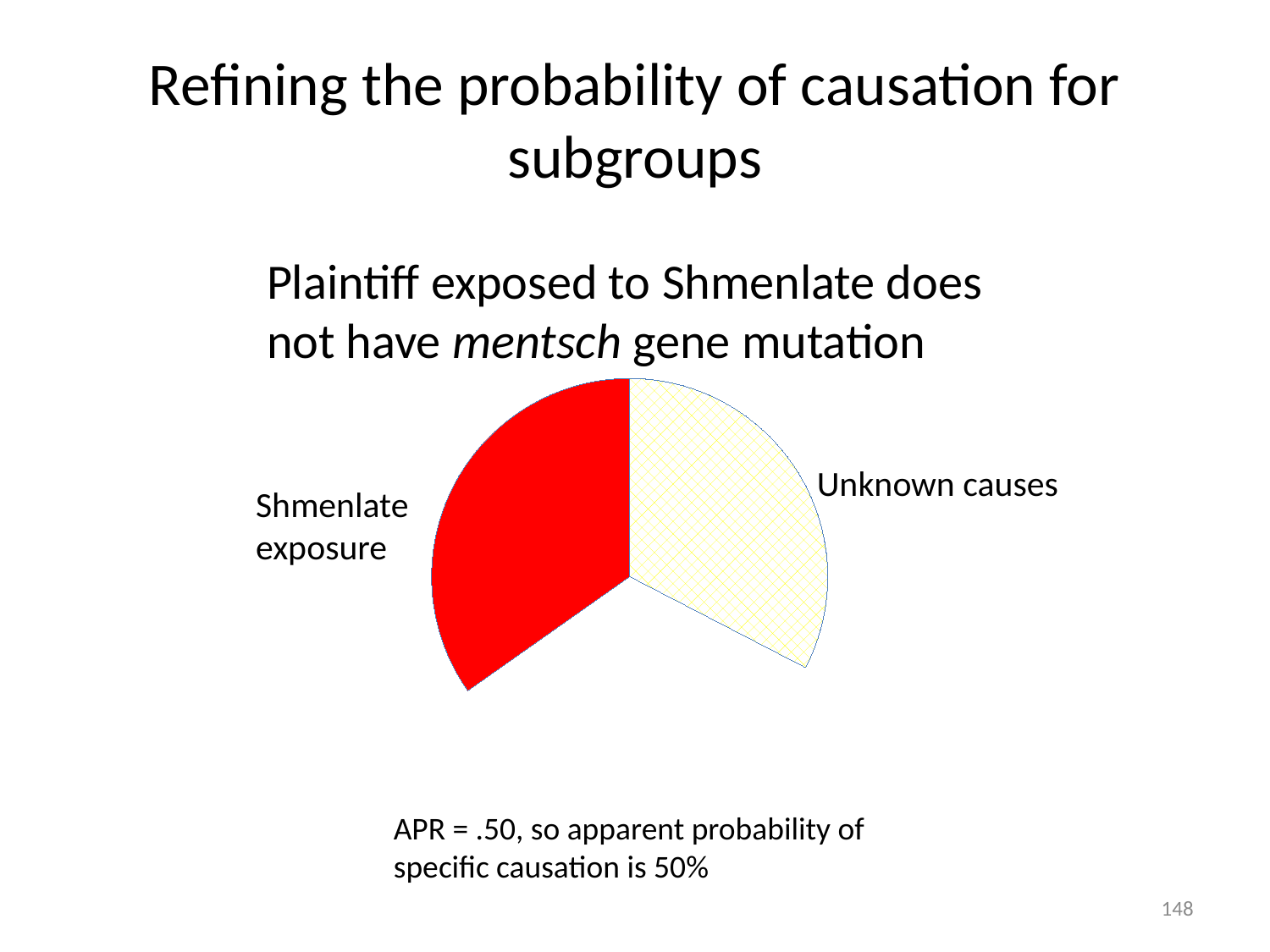
Which slice of the pie chart is coloured solid red? Shmenlate exposure What kind of chart is shown on the slide? pie chart According to the text below the pie chart, what is the apparent probability of specific causation? 50% According to the slide, what is the APR value? .50 How many slices does the pie chart have? 2 What are the labels of the two slices in the pie chart? Shmenlate exposure and Unknown causes